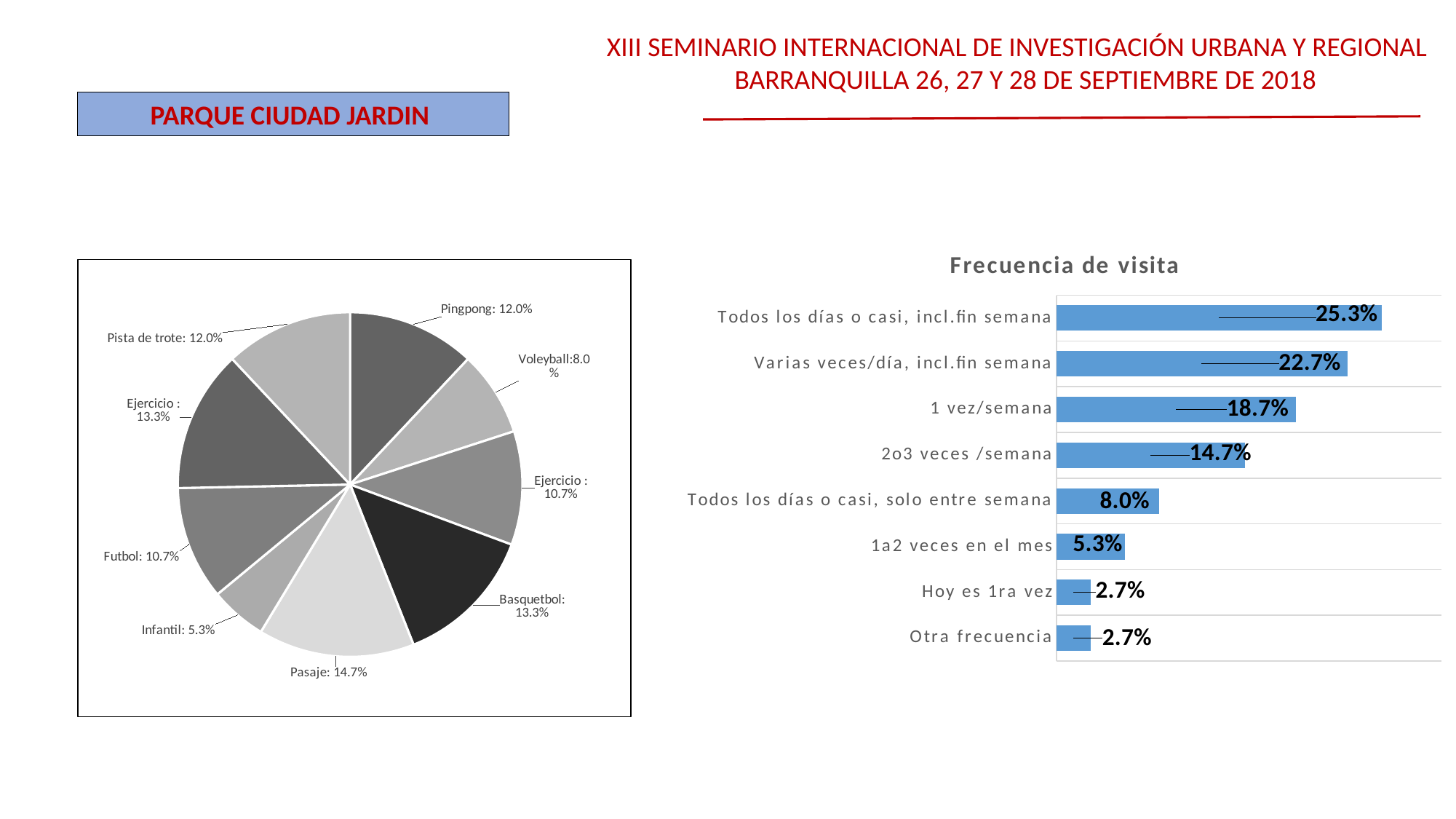
How many slices does the pie chart on the left have? 9 In the pie chart on the left, which slice is the smallest? Infantil What kind of chart is the 'Frecuencia de visita' chart? Bar chart In the pie chart on the left, what share does 'Pasaje' have? 14.7% In the 'Frecuencia de visita' chart, which is larger: '1a2 veces en el mes' or 'Todos los días o casi, solo entre semana'? Todos los días o casi, solo entre semana In the 'Frecuencia de visita' chart, which category has the highest value? Todos los días o casi, incl.fin semana In the 'Frecuencia de visita' chart, what is the value for 'Todos los días o casi, incl.fin semana'? 25.3% In the pie chart on the left, what is the difference between 'Basquetbol' and 'Voleyball'? 5.3% How many categories are shown in the 'Frecuencia de visita' chart? 8 In the pie chart on the left, what is the value for 'Infantil'? 5.3% In the 'Frecuencia de visita' chart, what is the difference between 'Varias veces/día, incl.fin semana' and '2o3 veces /semana'? 8.0% In the 'Frecuencia de visita' chart, what is the value for '1 vez/semana'? 18.7%